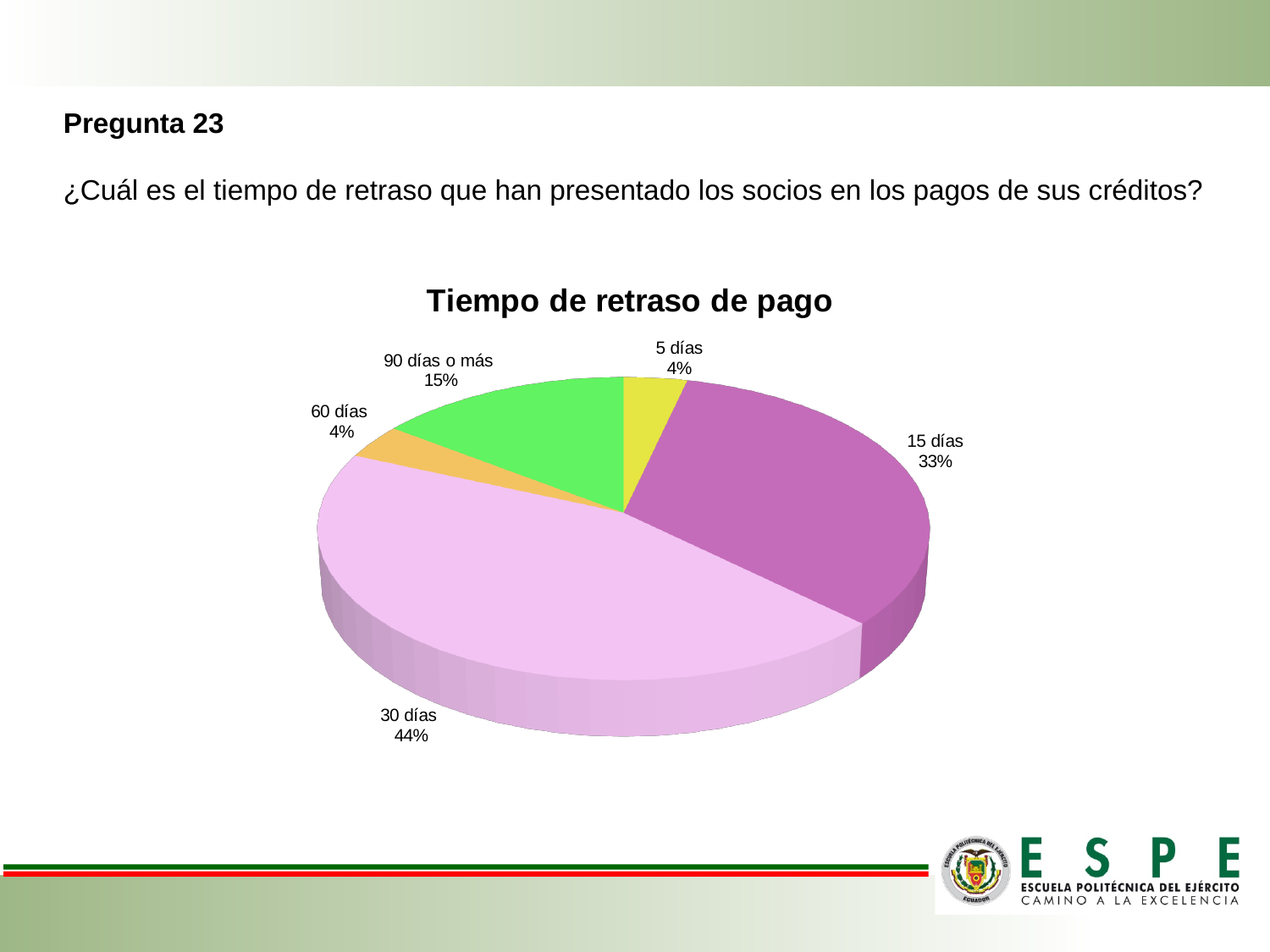
How many categories are shown in the pie chart? 5 What is the value shown for '5 días'? 4% Which category has the largest slice of the pie? 30 días What kind of chart is shown on the slide? Pie chart What share of the pie does the '15 días' slice represent? 33% What is the title of the chart? Tiempo de retraso de pago What is the difference in percentage points between '30 días' and '15 días'? 11 What is the value shown for '90 días o más'? 15% What is the difference in percentage points between '90 días o más' and '60 días'? 11 What share of the pie does the '30 días' slice represent? 44% What is the value shown for '60 días'? 4% Which is larger, the slice for '15 días' or the slice for '90 días o más'? 15 días